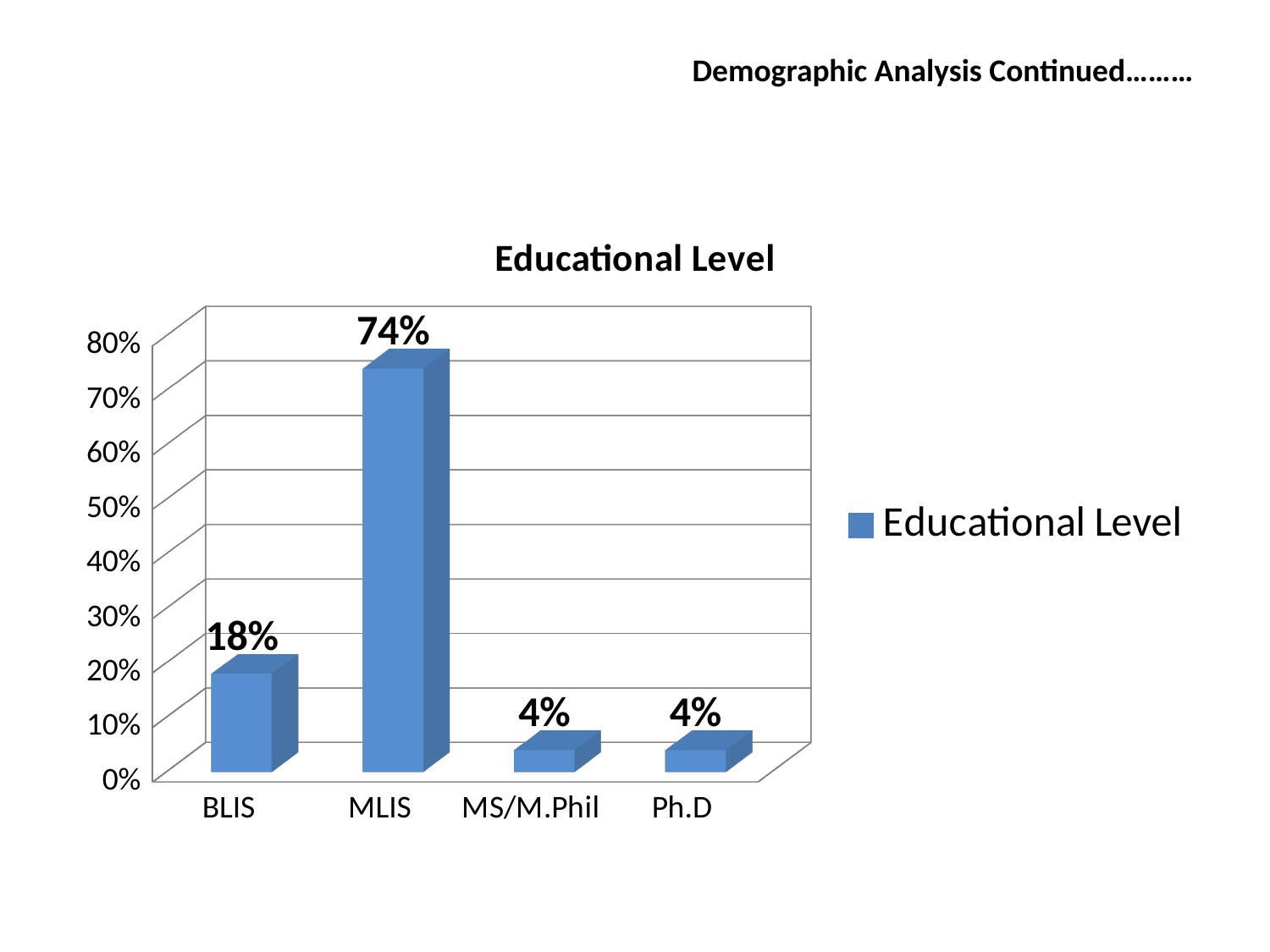
Which category has the highest value? MLIS How many categories are shown on the x axis? 4 Is the value for MLIS greater or less than 70%? greater What kind of chart is shown? bar chart What is the value for Ph.D? 4% What is the title of the chart? Educational Level What is the value for MS/M.Phil? 4% What is the value for BLIS? 18% Which is larger, the value for BLIS or the value for MS/M.Phil? BLIS What is the value for MLIS? 74% How many series does the legend list? 1 What is the difference between the values for MLIS and BLIS? 56%